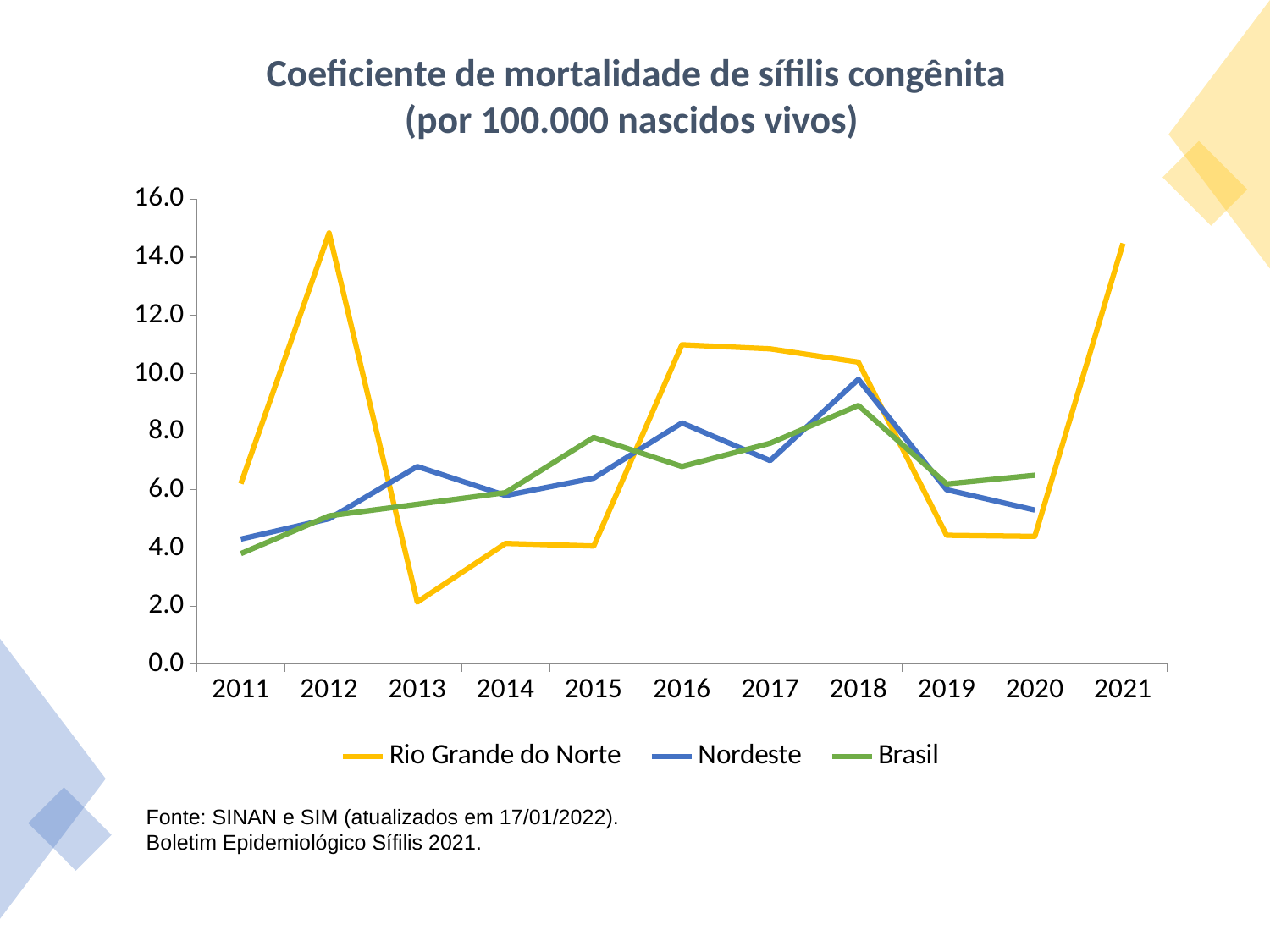
In which year is the Brasil line at its lowest? 2011 In which year is the Rio Grande do Norte line at its lowest? 2013 In which year does the Brasil line reach its highest value? 2018 How many series does the legend list? 3 In 2016, which series has the higher value, Rio Grande do Norte or Nordeste? Rio Grande do Norte How many years are shown on the x axis? 11 Is the value for Rio Grande do Norte in 2013 greater or less than 4.0? less What kind of chart is shown on the slide? Line chart In which year does the Nordeste line reach its highest value? 2018 In 2015, which series has the higher value, Brasil or Nordeste? Brasil Is the value for Nordeste in 2018 greater or less than 8.0? greater Is the value for Rio Grande do Norte in 2012 greater or less than 14.0? greater